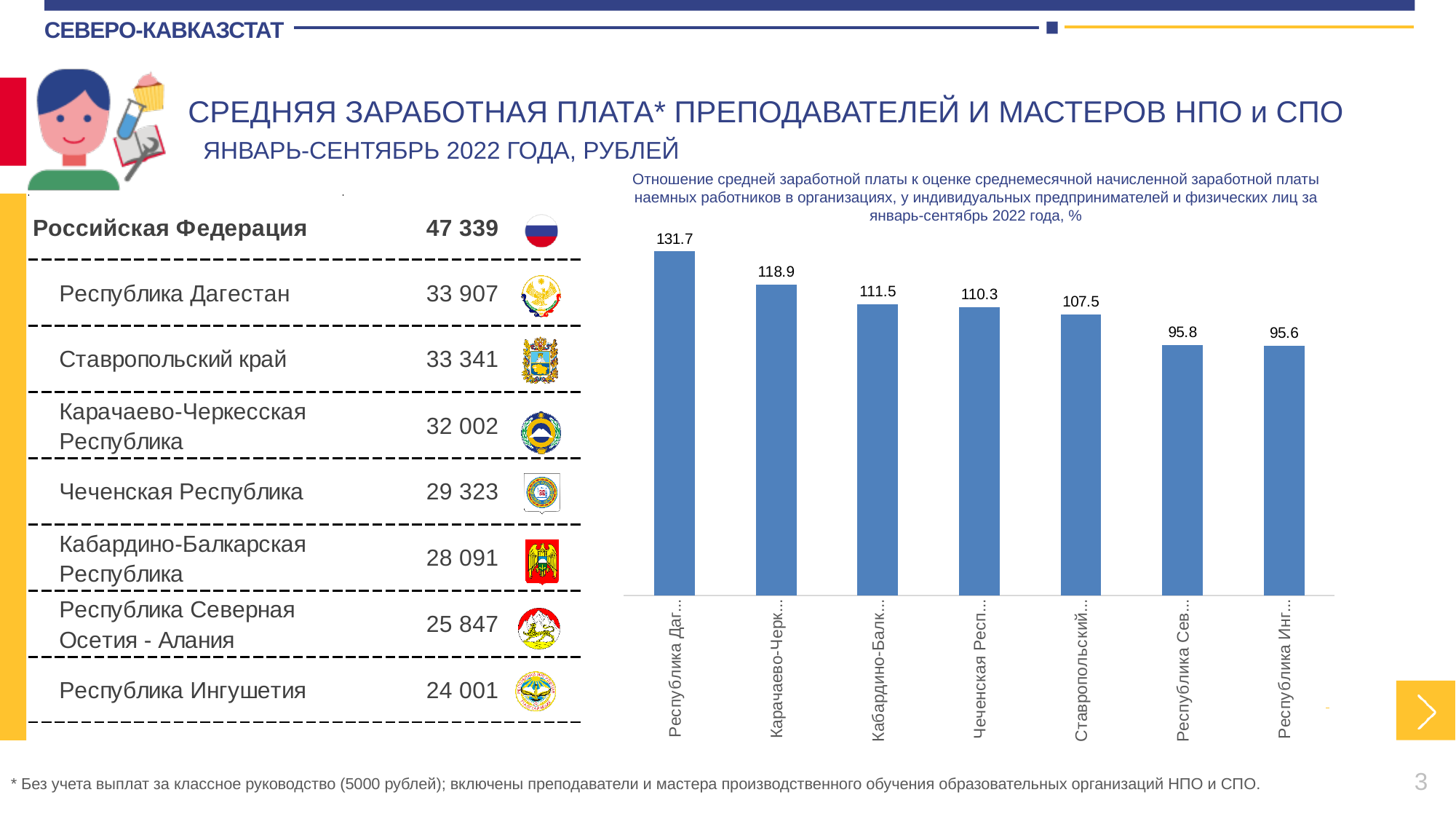
What is the value shown for Карачаево-Черкесская Республика in the chart? 118.9 What is the difference between the values for Республика Дагестан and Чеченская Республика in the chart? 21.4 What is the value shown for Республика Дагестан in the chart? 131.7 What unit is stated in the chart title for the plotted values? % What is the value shown for Республика Ингушетия in the chart? 95.6 Which is larger in the chart: the value for Кабардино-Балкарская Республика or the value for Республика Северная Осетия - Алания? Кабардино-Балкарская Республика Which region has the highest value in the chart? Республика Дагестан Do the bar values rise or fall from left to right along the x axis? fall How many bars (regions) are plotted in the chart? 7 What is the value shown for Ставропольский край in the chart? 107.5 What kind of chart is shown on the slide? bar chart Which region has the lowest value in the chart? Республика Ингушетия